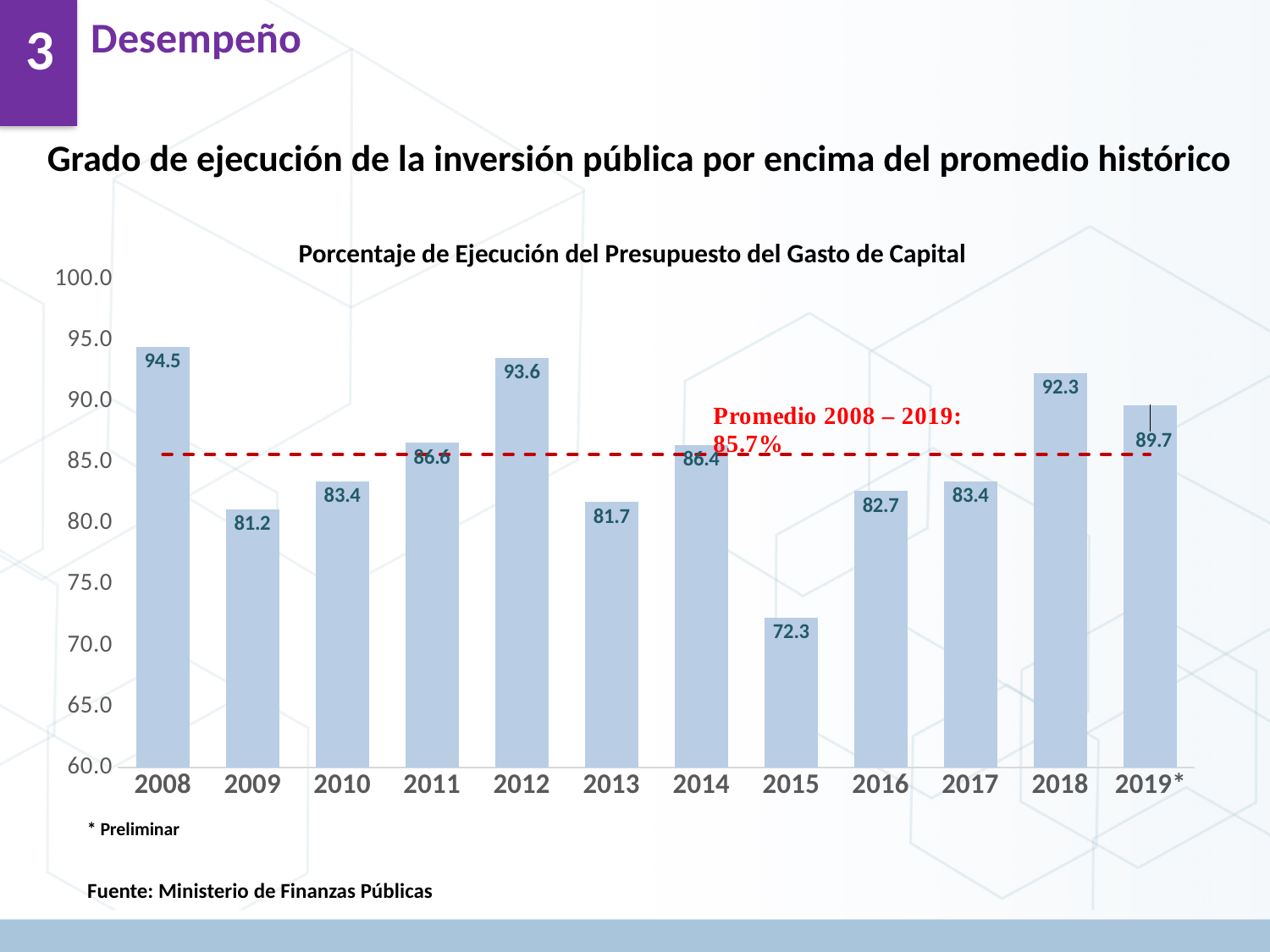
Which year has the highest value in the chart? 2008 What average value for 2008 – 2019 is indicated by the dashed red line? 85.7% What is the value for 2008 in the chart? 94.5 What kind of chart is shown on the slide? Bar chart Which year has the lowest value in the chart? 2015 Which is larger, the value for 2012 or the value for 2018? 2012 What is the value for 2015 in the chart? 72.3 What is the difference between the values for 2008 and 2009? 13.3 How many years are shown on the x axis of the chart? 12 Is the value for 2014 greater or less than 80.0? greater What is the difference between the values for 2018 and 2017? 8.9 What is the value for 2019* in the chart? 89.7